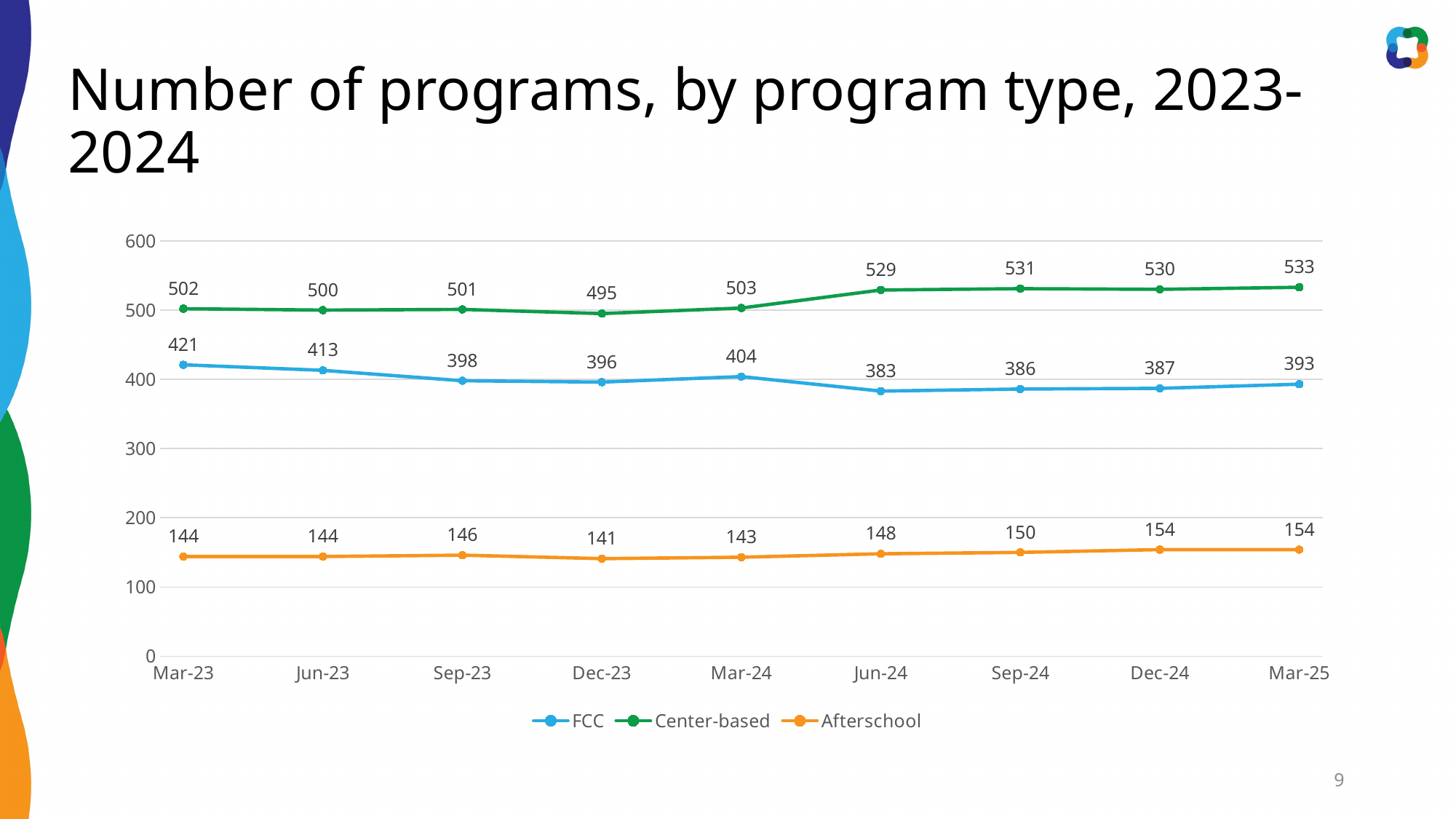
How many time periods are shown on the x axis? 9 How many series does the legend list? 3 Is the Afterschool value in Dec-24 greater or less than 200? less What is the value for Afterschool in Sep-24? 150 Which is larger in Jun-24: the FCC value or the Afterschool value? FCC What is the difference between the Center-based and FCC values in Mar-23? 81 What is the value for Center-based in Mar-25? 533 What kind of chart is shown on the slide? line chart In which period is the FCC value lowest? Jun-24 In which period is the Center-based value highest? Mar-25 Does the FCC value rise or fall from Mar-23 to Jun-24? fall What is the value for FCC in Dec-23? 396